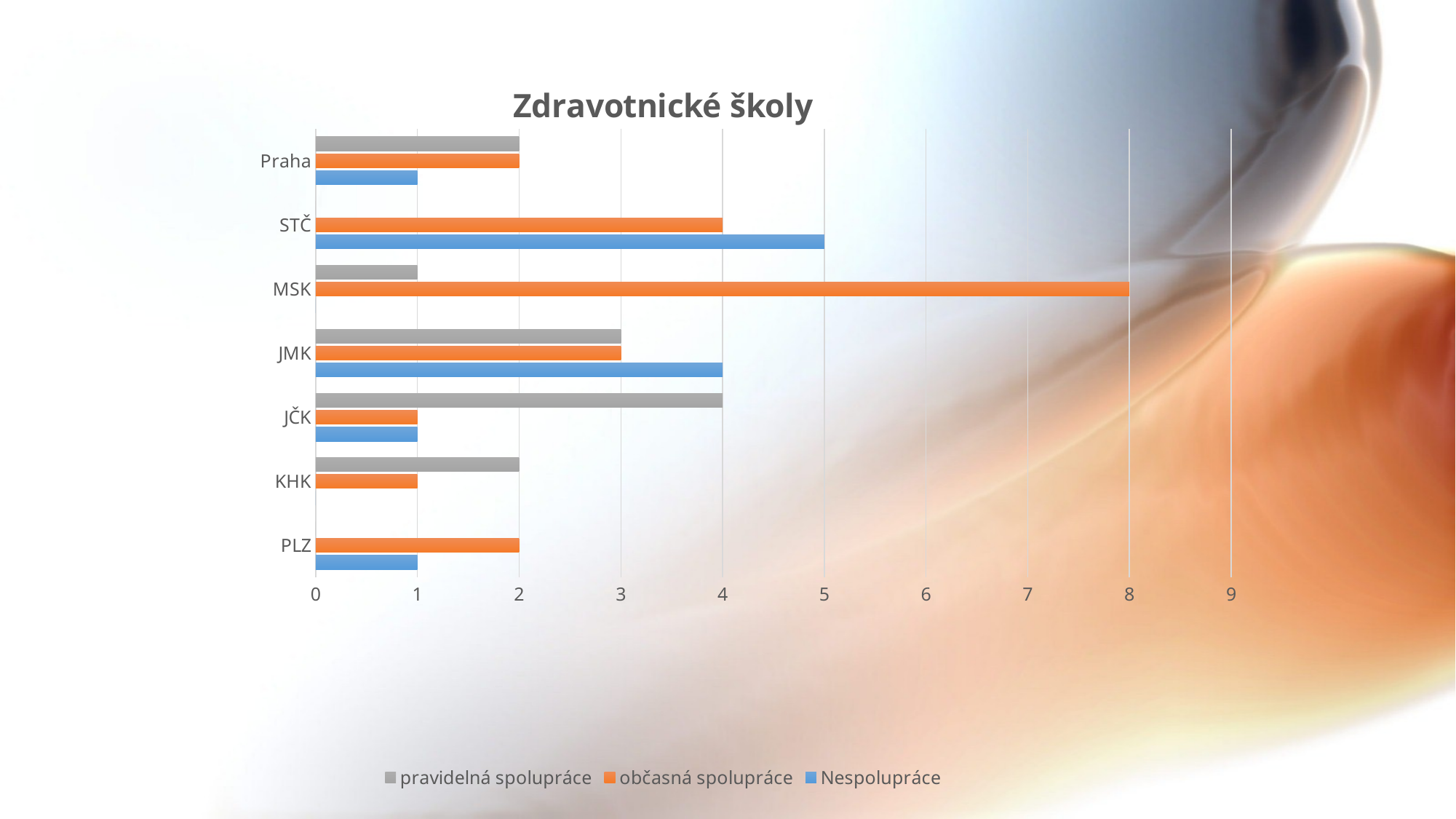
How many categories are shown on the vertical axis? 7 Which colour represents Nespolupráce in the legend? blue How many series does the legend list? 3 What is the value of Nespolupráce for STČ? 5 What is the title of the chart? Zdravotnické školy Which is larger: pravidelná spolupráce for JMK or pravidelná spolupráce for Praha? pravidelná spolupráce for JMK What is the value of občasná spolupráce for MSK? 8 What type of chart is shown on the slide? bar chart What is the value of pravidelná spolupráce for JČK? 4 What is the difference between občasná spolupráce for MSK and občasná spolupráce for STČ? 4 Which category has the highest value for občasná spolupráce? MSK Which category has the highest value for Nespolupráce? STČ